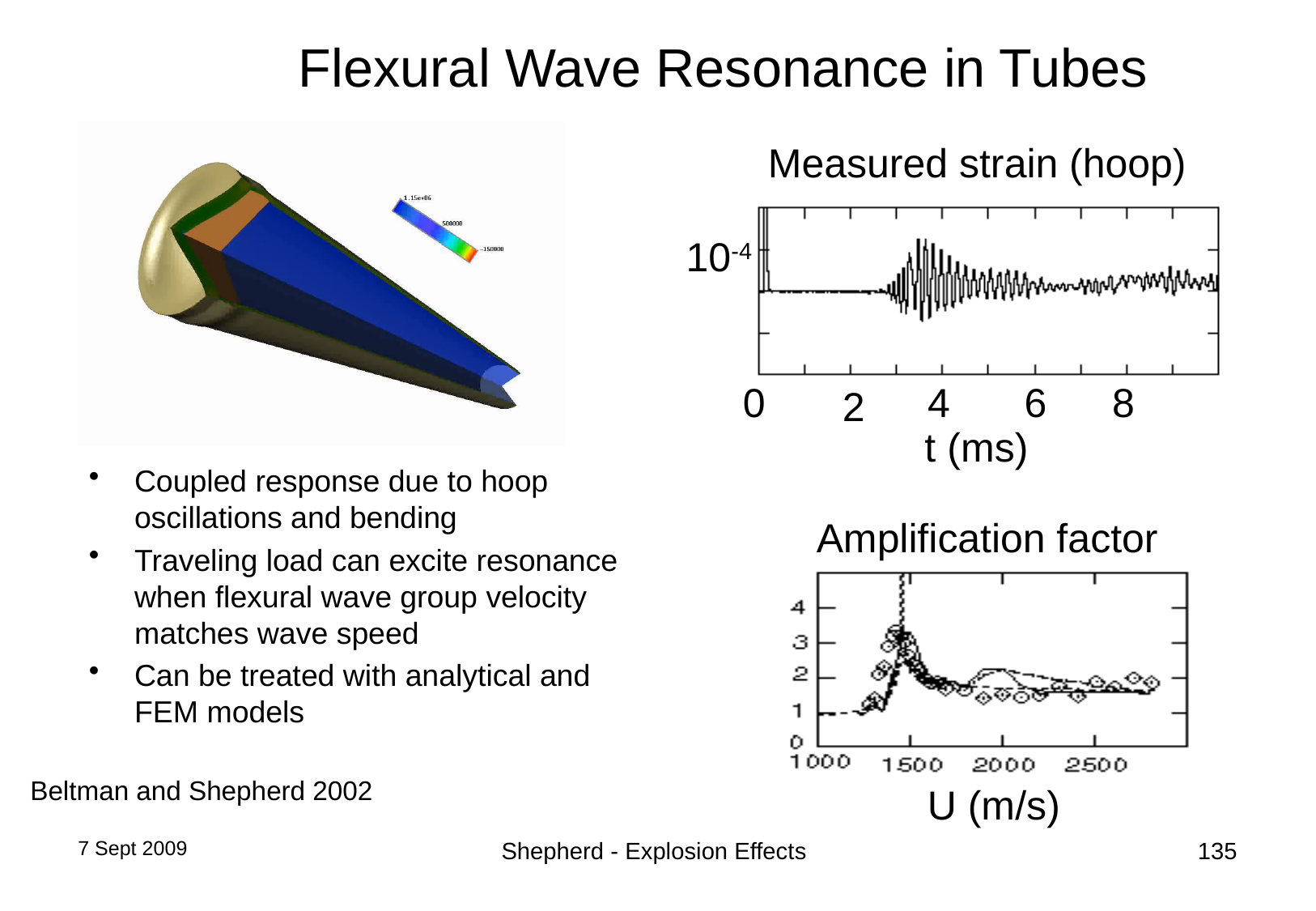
In the "Amplification factor" chart, what is the label of the x axis? U (m/s) What kind of chart is the "Amplification factor" chart? line chart with scatter points In the "Amplification factor" chart, is the amplification factor at U = 2500 m/s greater or less than 2? less In the "Amplification factor" chart, is the amplification factor at U = 1000 m/s greater or less than 2? less In the "Amplification factor" chart, does the amplification factor rise or fall as U increases from 1000 m/s to about 1450 m/s? rise What kind of chart is the "Measured strain (hoop)" chart? line chart In the "Amplification factor" chart, is the amplification factor at U = 1500 m/s greater or less than 2? greater In the "Amplification factor" chart, does the amplification factor rise or fall as U increases from about 1450 m/s to 1700 m/s? fall In the "Amplification factor" chart, what is the highest value shown on the y axis? 4 In the "Amplification factor" chart, is the amplification factor larger at U = 1500 m/s or at U = 2500 m/s? U = 1500 m/s In the "Measured strain (hoop)" chart, what is the label of the x axis? t (ms)